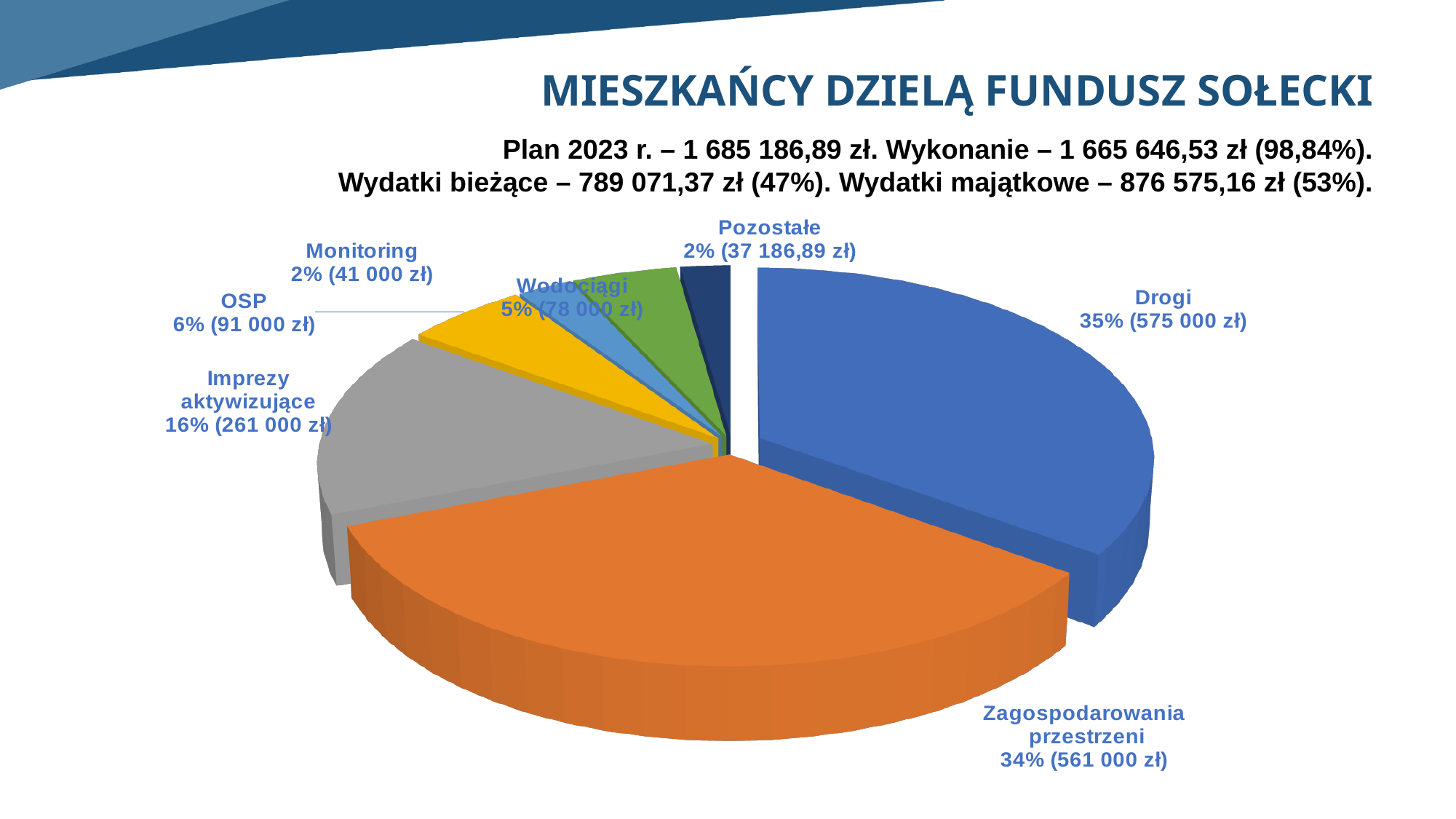
What is the difference in amount between Drogi and Zagospodarowania przestrzeni? 14 000 zł What colour is the Imprezy aktywizujące slice? grey What amount is shown for the Drogi slice? 575 000 zł What amount is shown for the Imprezy aktywizujące slice? 261 000 zł What share of the pie does OSP represent? 6% What kind of chart is shown on the slide? pie chart Which category has the largest share of the pie? Drogi What amount is shown for the Pozostałe slice? 37 186,89 zł How many slices does the pie chart have? 7 Which is larger, the amount for Wodociągi or the amount for Monitoring? Wodociągi Which category has the smallest amount in the pie chart? Pozostałe What share of the pie does Zagospodarowania przestrzeni represent? 34%